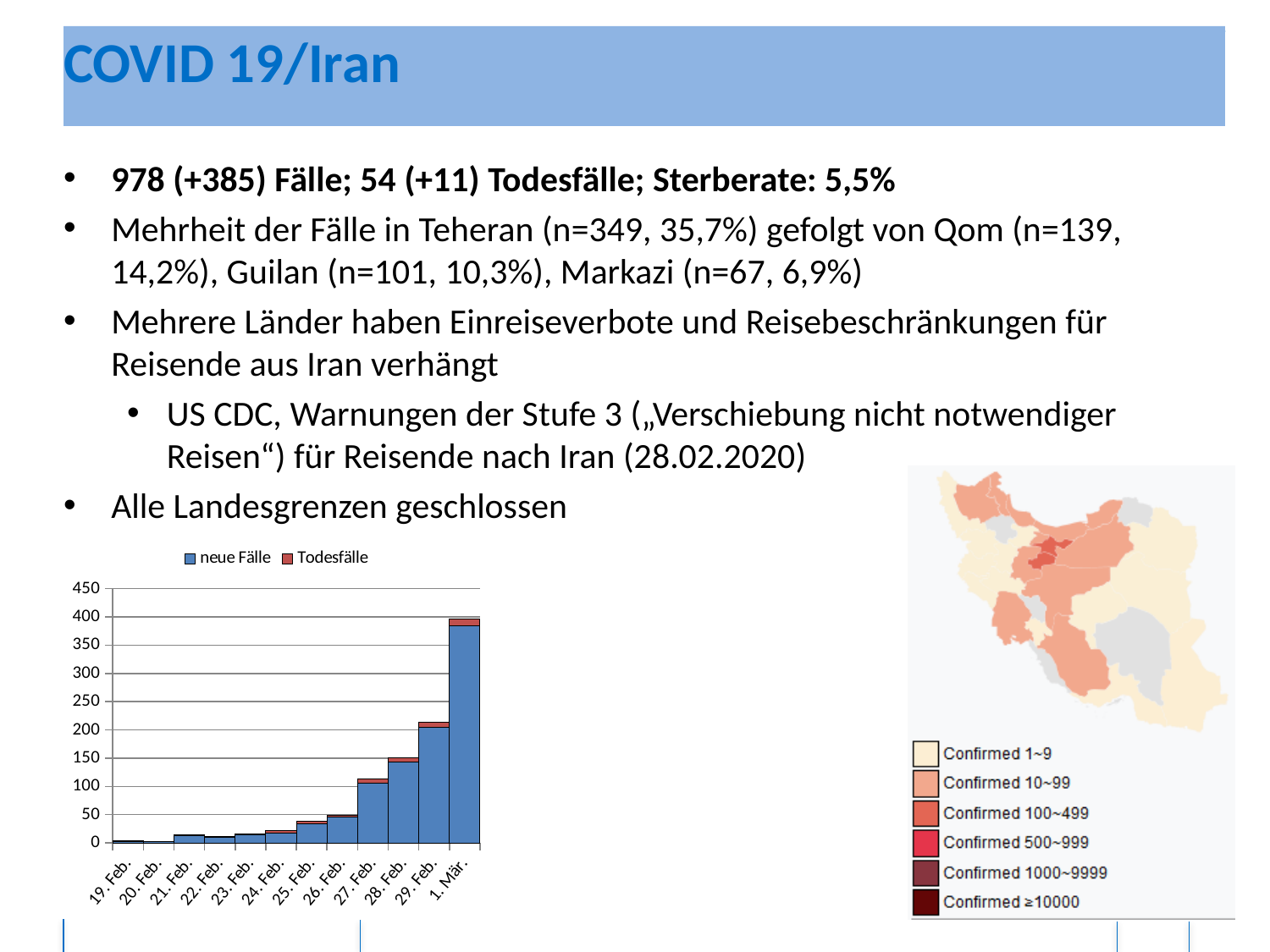
Is the total bar for 29. Feb. greater or less than 150? greater Is the total bar for 26. Feb. greater or less than 100? less Is the total bar for 1. Mär. greater or less than 350? greater Which colour represents the series 'neue Fälle' in the bar chart? blue What are the two series named in the legend of the bar chart? neue Fälle and Todesfälle Do the bars generally rise or fall from 19. Feb. to 1. Mär.? rise Which bar is taller, 1. Mär. or 29. Feb.? 1. Mär. What kind of chart is shown at the bottom left of the slide? bar chart How many series does the legend of the bar chart list? 2 Which date has the highest bar in the chart? 1. Mär. How many dates are shown on the x axis of the bar chart? 12